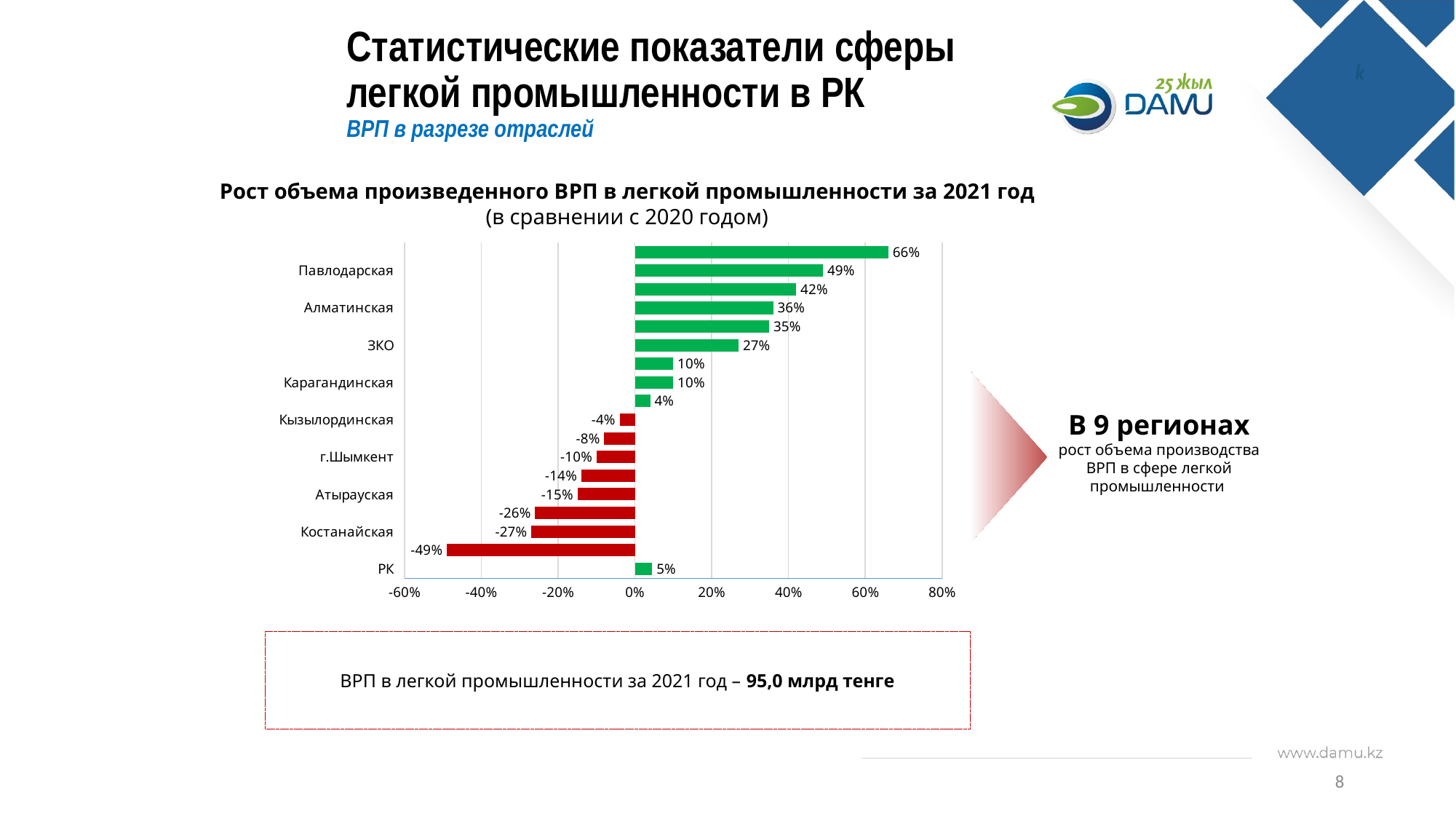
How many bars on the chart show a negative value? 8 What is the value for Павлодарская? 49% Which is larger, the value for Павлодарская or the value for Алматинская? Павлодарская What kind of chart is shown on the slide? Bar chart What is the value for РК? 5% What is the value for Костанайская? -27% What is the lowest value shown on the chart? -49% What is the difference between the highest value (66%) and the lowest value (-49%) on the chart? 115 percentage points What is the highest value shown on the chart? 66% What is the value for ЗКО? 27% How many bars are plotted on the chart? 18 What is the title of the chart? Рост объема произведенного ВРП в легкой промышленности за 2021 год (в сравнении с 2020 годом)